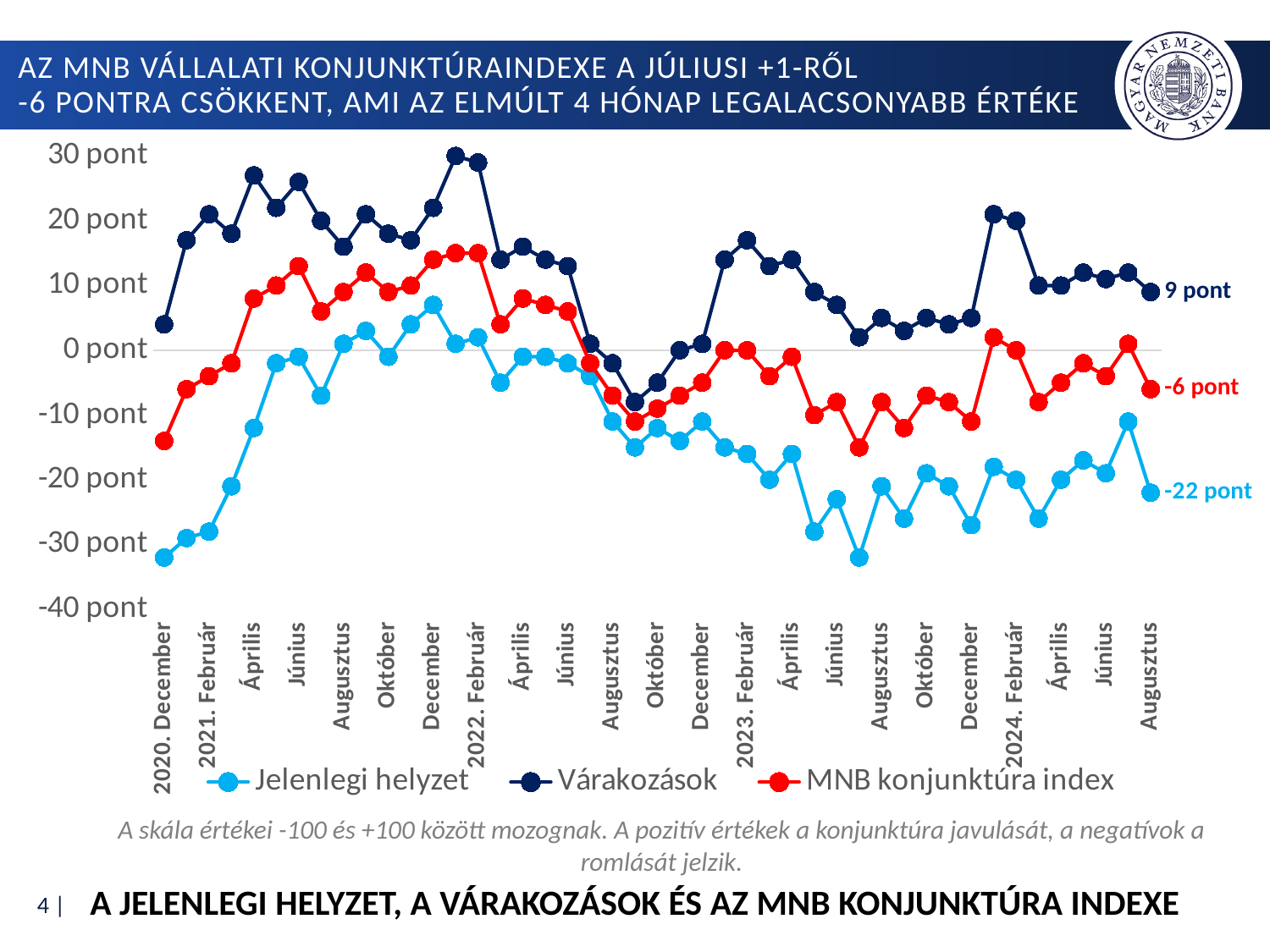
At 2024 Augusztus, what is the difference between the Várakozások value and the MNB konjunktúra index value? 15 pont What is the value of the Várakozások series at the last point (2024 Augusztus)? 9 pont At 2024 Augusztus, what is the difference between the MNB konjunktúra index value and the Jelenlegi helyzet value? 16 pont Is the value of the Jelenlegi helyzet series at 2020 December greater or less than -30 pont? less What is the value of the Jelenlegi helyzet series at the last point (2024 Augusztus)? -22 pont At 2024 Augusztus, which series has the lowest value? Jelenlegi helyzet What kind of chart is shown on the slide? line chart At 2024 Augusztus, which is larger: the Várakozások value or the Jelenlegi helyzet value? Várakozások What is the value of the MNB konjunktúra index at the last point (2024 Augusztus)? -6 pont At 2024 Augusztus, which series has the highest value? Várakozások How many series does the legend list? 3 Is the value of the Várakozások series at 2021 Április greater or less than 20 pont? greater